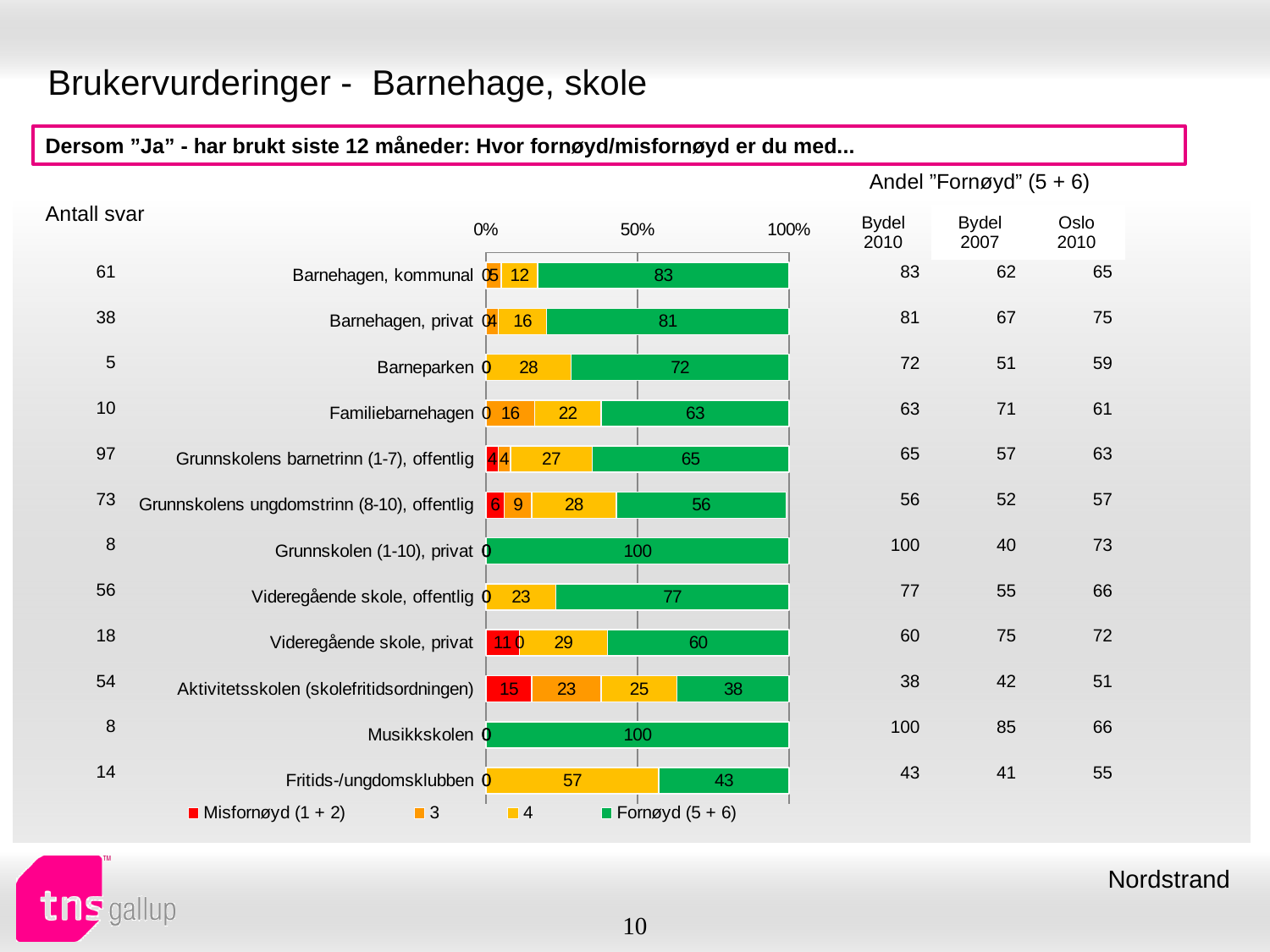
Which has the larger Fornøyd (5 + 6) value: Videregående skole, offentlig or Videregående skole, privat? Videregående skole, offentlig What colour represents Fornøyd (5 + 6) in the chart? green What is the Fornøyd (5 + 6) value for Aktivitetsskolen (skolefritidsordningen)? 38 What is the value of the '3' segment for Familiebarnehagen? 16 What is the value of the '4' segment for Fritids-/ungdomsklubben? 57 What kind of chart is shown on the slide? bar chart What is the Fornøyd (5 + 6) value for Grunnskolens ungdomstrinn (8-10), offentlig? 56 How many categories (services) are plotted in the chart? 12 Which category has the lowest Fornøyd (5 + 6) value? Aktivitetsskolen (skolefritidsordningen) What is the difference between the Fornøyd (5 + 6) values for Barnehagen, kommunal and Barnehagen, privat? 2 Which category has the highest Misfornøyd (1 + 2) value? Aktivitetsskolen (skolefritidsordningen) How many series does the chart legend list? 4